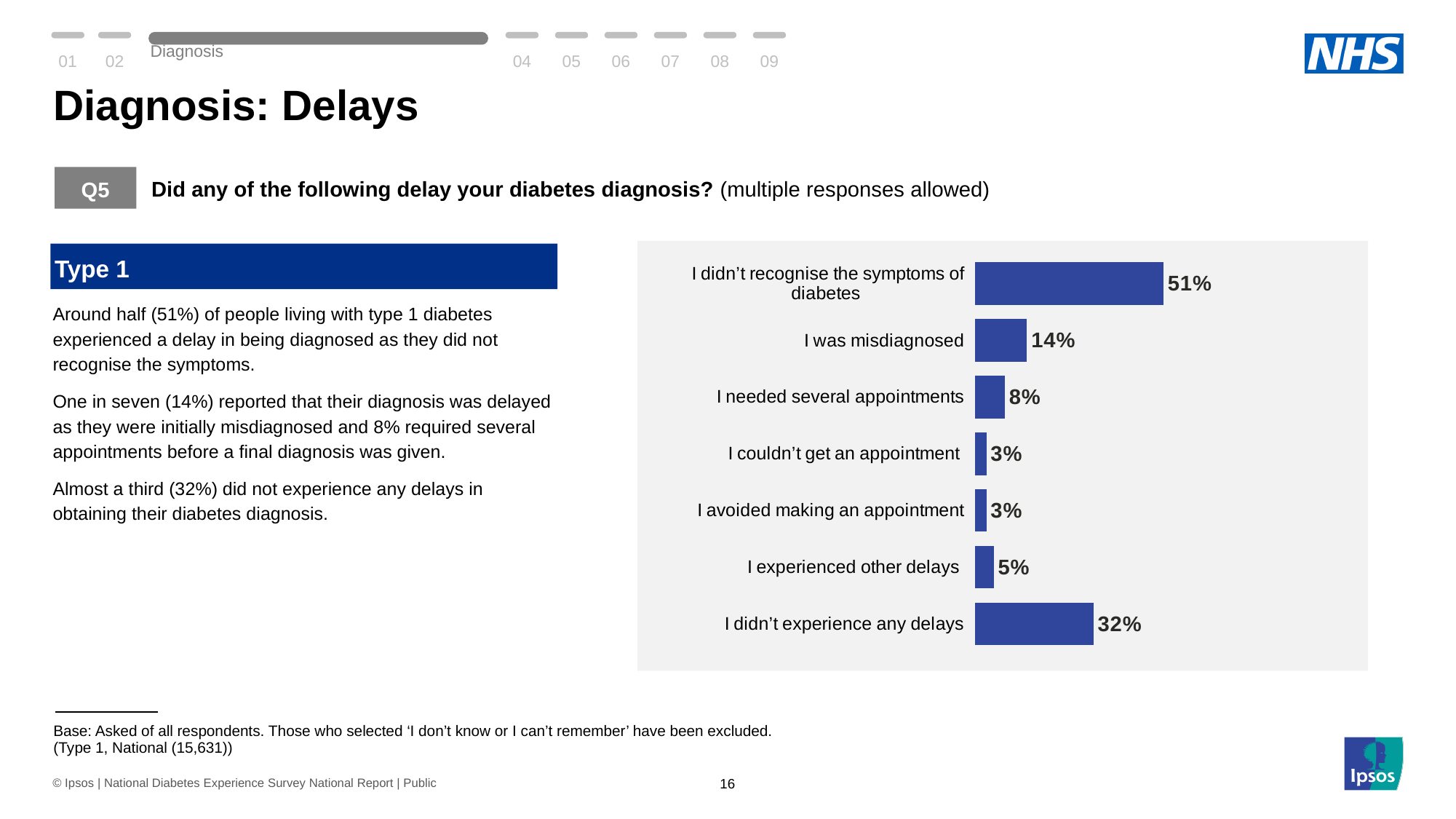
What percentage of respondents said they didn't recognise the symptoms of diabetes? 51% Which two categories share the same value of 3%? I couldn't get an appointment; I avoided making an appointment Which is larger: 'I needed several appointments' or 'I experienced other delays'? I needed several appointments Which category has the highest value in the chart? I didn't recognise the symptoms of diabetes How many categories are shown in the chart? 7 What is the value for 'I was misdiagnosed'? 14% What kind of chart is shown on the slide? Bar chart What is the value for 'I experienced other delays'? 5% What is the difference between 'I didn't recognise the symptoms of diabetes' and 'I didn't experience any delays'? 19 percentage points What percentage of respondents said they didn't experience any delays? 32% What is the difference between 'I was misdiagnosed' and 'I needed several appointments'? 6 percentage points Which diabetes type does the chart on this slide cover? Type 1